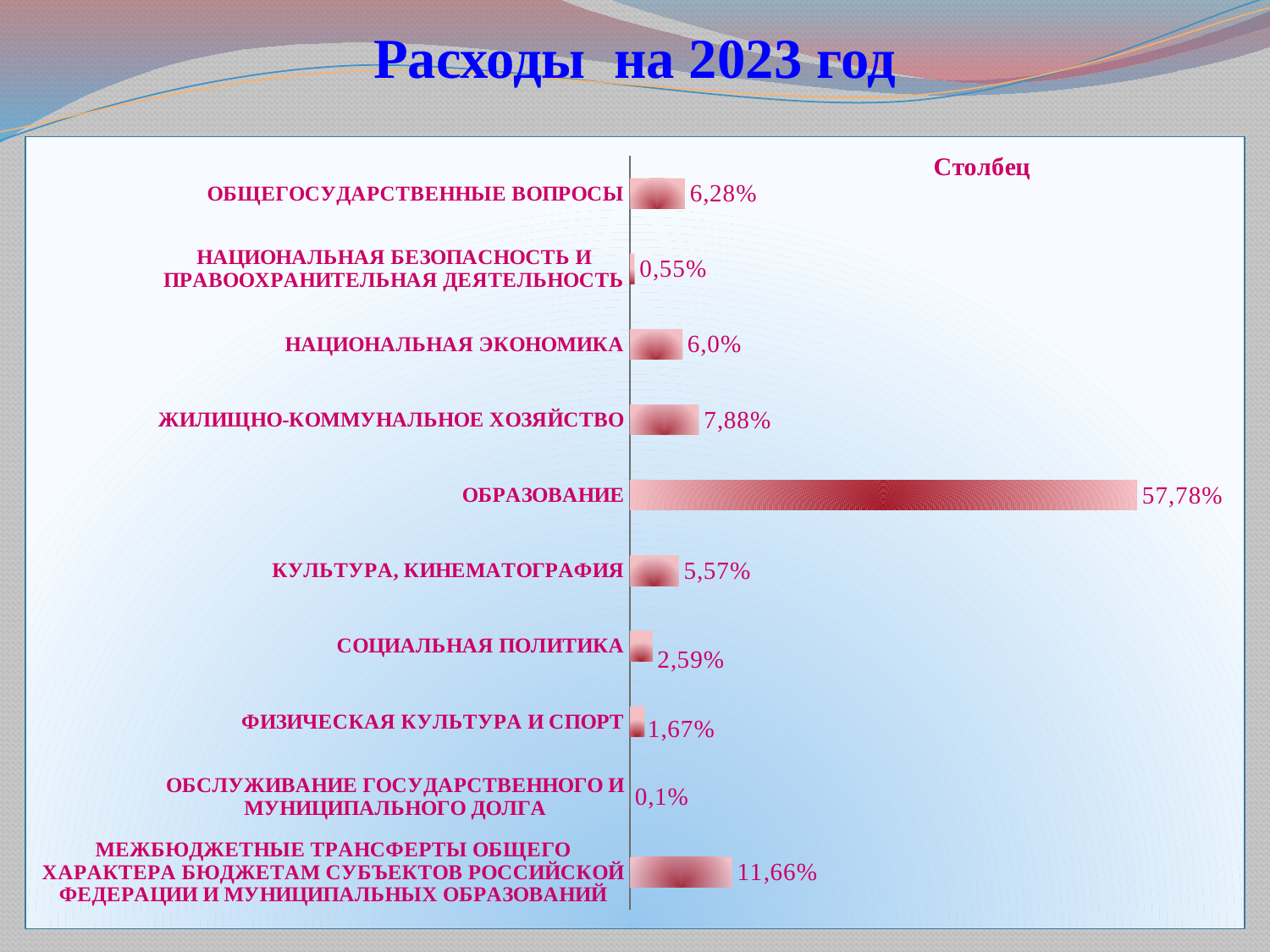
What is the title of the slide? Расходы на 2023 год What is the value for СОЦИАЛЬНАЯ ПОЛИТИКА? 2,59% What is the value for ОБРАЗОВАНИЕ? 57,78% What kind of chart is shown on the slide? Bar chart What is the difference between the values for ОБЩЕГОСУДАРСТВЕННЫЕ ВОПРОСЫ and НАЦИОНАЛЬНАЯ ЭКОНОМИКА? 0,28% Which is larger: the value for КУЛЬТУРА, КИНЕМАТОГРАФИЯ or the value for ФИЗИЧЕСКАЯ КУЛЬТУРА И СПОРТ? КУЛЬТУРА, КИНЕМАТОГРАФИЯ How many categories are shown in the chart? 10 Which category has the highest value? ОБРАЗОВАНИЕ Which category has the lowest value? ОБСЛУЖИВАНИЕ ГОСУДАРСТВЕННОГО И МУНИЦИПАЛЬНОГО ДОЛГА What is the value for ОБСЛУЖИВАНИЕ ГОСУДАРСТВЕННОГО И МУНИЦИПАЛЬНОГО ДОЛГА? 0,1% What is the value for ЖИЛИЩНО-КОММУНАЛЬНОЕ ХОЗЯЙСТВО? 7,88%